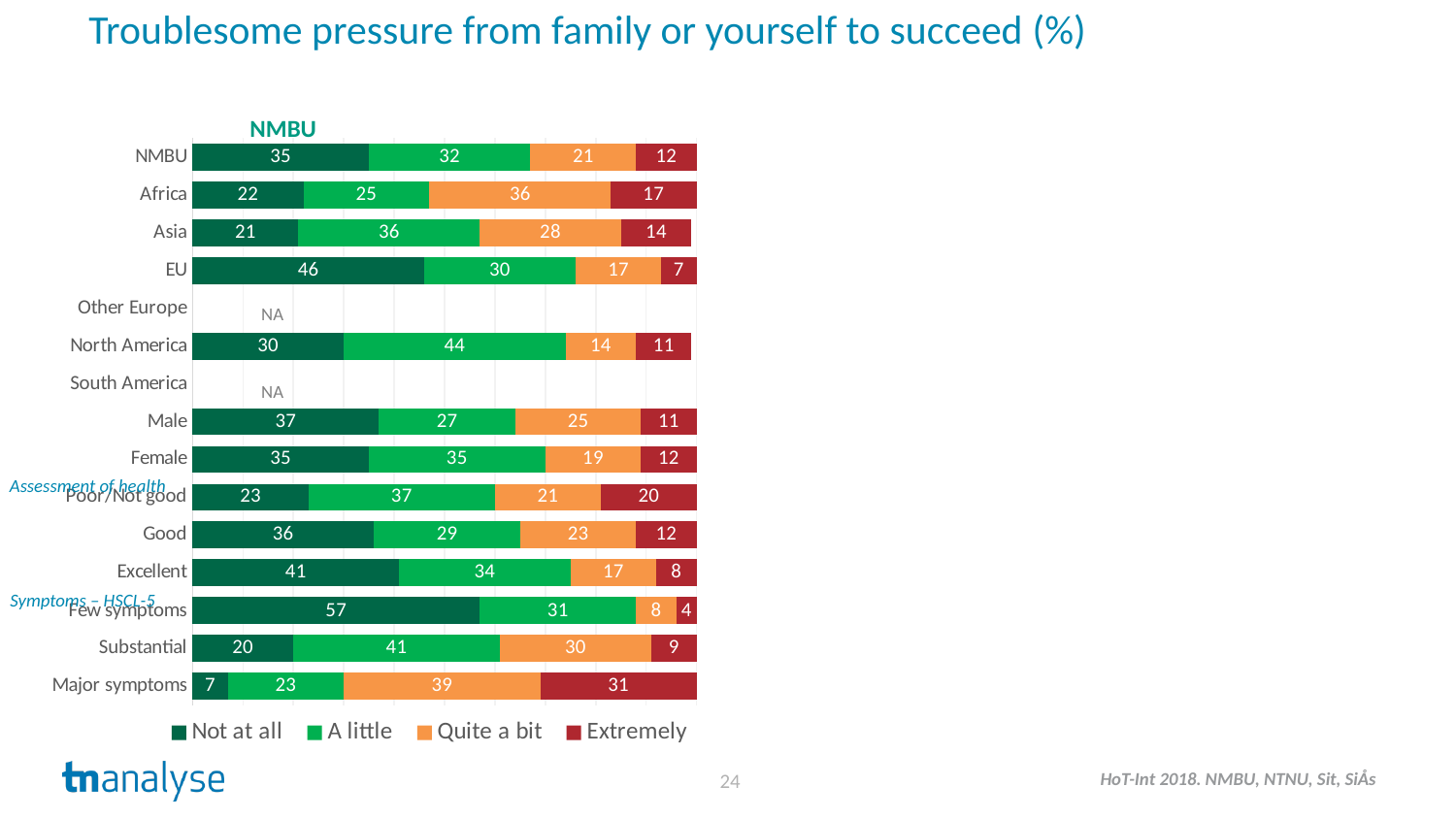
Which has a larger 'Extremely' value, Poor/Not good or Good? Poor/Not good What is the 'Quite a bit' value for Africa? 36 What is the title of the chart? Troublesome pressure from family or yourself to succeed (%) How many series does the legend list? 4 What is the 'Extremely' value for Major symptoms? 31 What kind of chart is shown on the slide? Stacked bar chart What is the 'Not at all' value for EU? 46 Which categories are shown as NA? Other Europe and South America Which category has the lowest 'Not at all' value? Major symptoms Which category has the highest 'Not at all' value? Few symptoms What is the difference between the 'A little' values for North America and Asia? 8 What is the total of the stacked bar for Male? 100